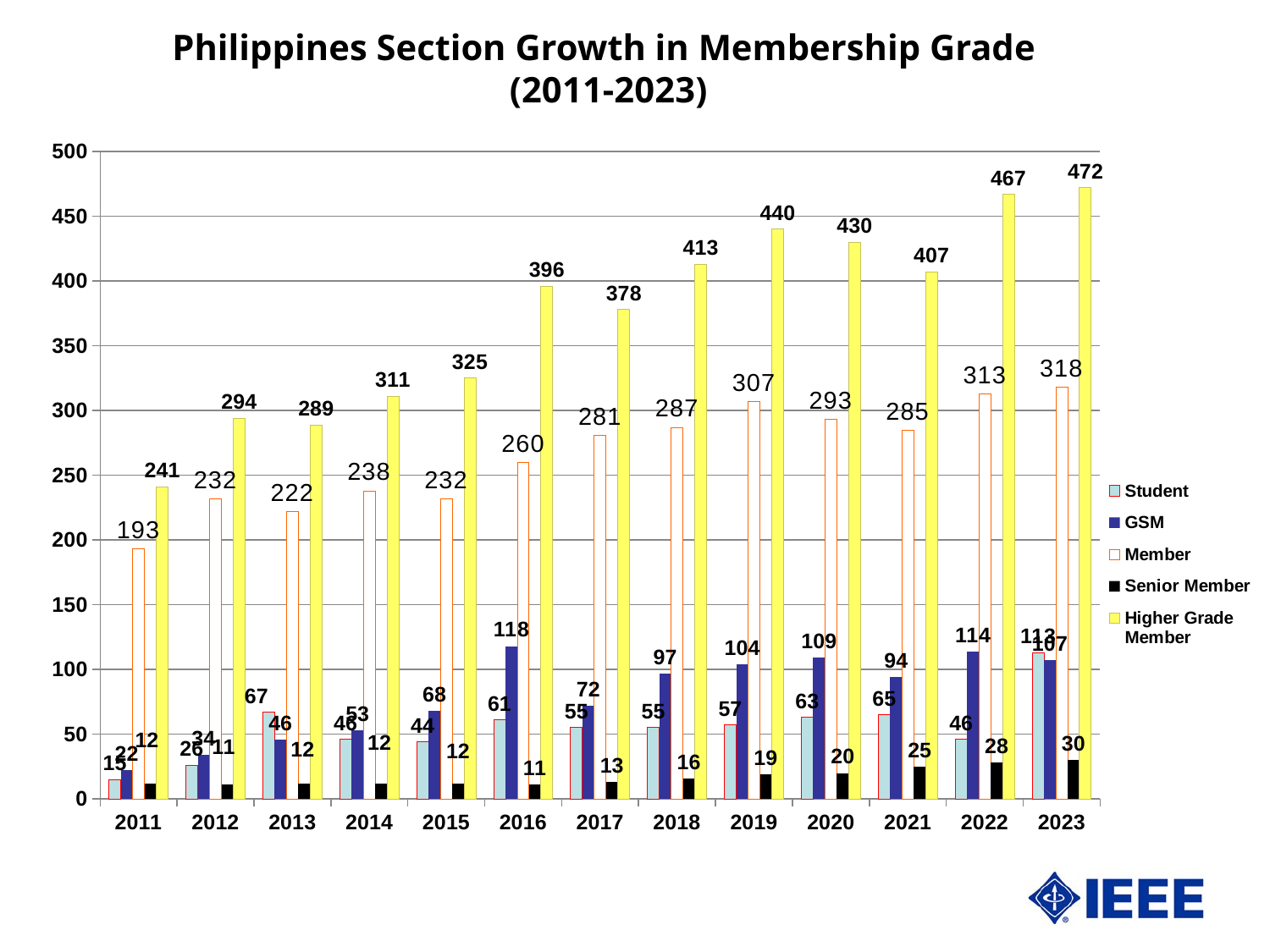
In which year is the Student value lowest? 2011 What is the Higher Grade Member value for 2023? 472 In which year is the Higher Grade Member value highest? 2023 How many series does the legend list? 5 What kind of chart is shown on the slide? Bar chart What is the Member value for 2019? 307 What is the Senior Member value for 2023? 30 What is the difference between the Higher Grade Member values for 2023 and 2011? 231 What colour are the Higher Grade Member bars? Yellow Do the Senior Member values rise or fall from 2016 to 2023? Rise How many years are shown on the x axis? 13 In 2013, which is larger, the Student value or the GSM value? Student